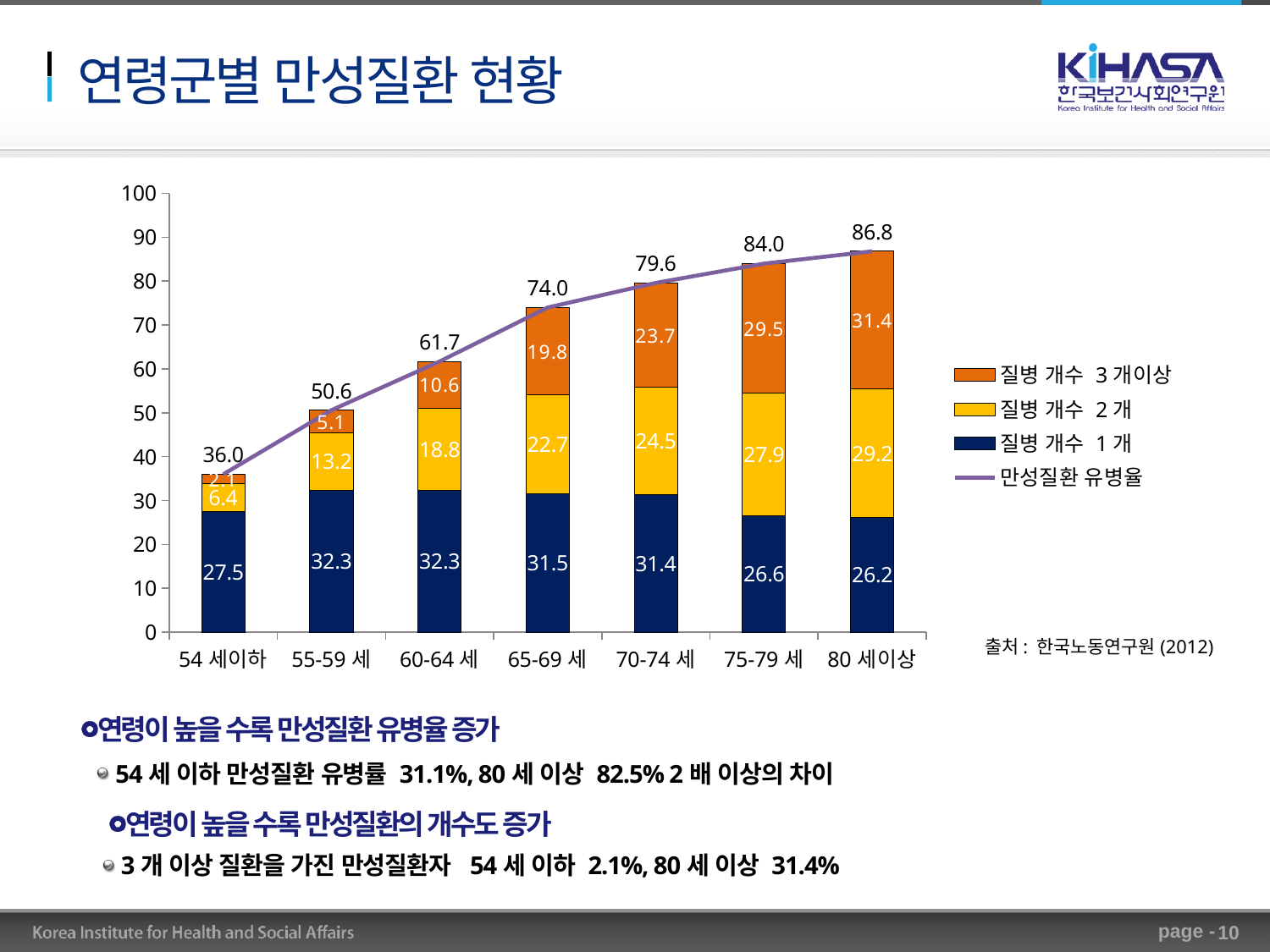
Does the 만성질환 유병율 line rise or fall as age increases along the x axis? rise What is the value of 질병 개수 3 개이상 for 80 세이상? 31.4 How many age groups are shown on the x axis? 7 Which is larger, 질병 개수 2 개 for 75-79 세 or 질병 개수 1 개 for 75-79 세? 질병 개수 2 개 What is the 만성질환 유병율 value for 70-74 세? 79.6 Which age group has the lowest value for 질병 개수 3 개이상? 54 세이하 What is the value of 질병 개수 2 개 for 65-69 세? 22.7 How many series does the legend list? 4 What type of chart is shown on the slide? stacked bar chart with a line What is the difference between the 만성질환 유병율 for 80 세이상 and 54 세이하? 50.8 What is the value of 질병 개수 1 개 for 54 세이하? 27.5 Which age group has the highest 만성질환 유병율? 80 세이상